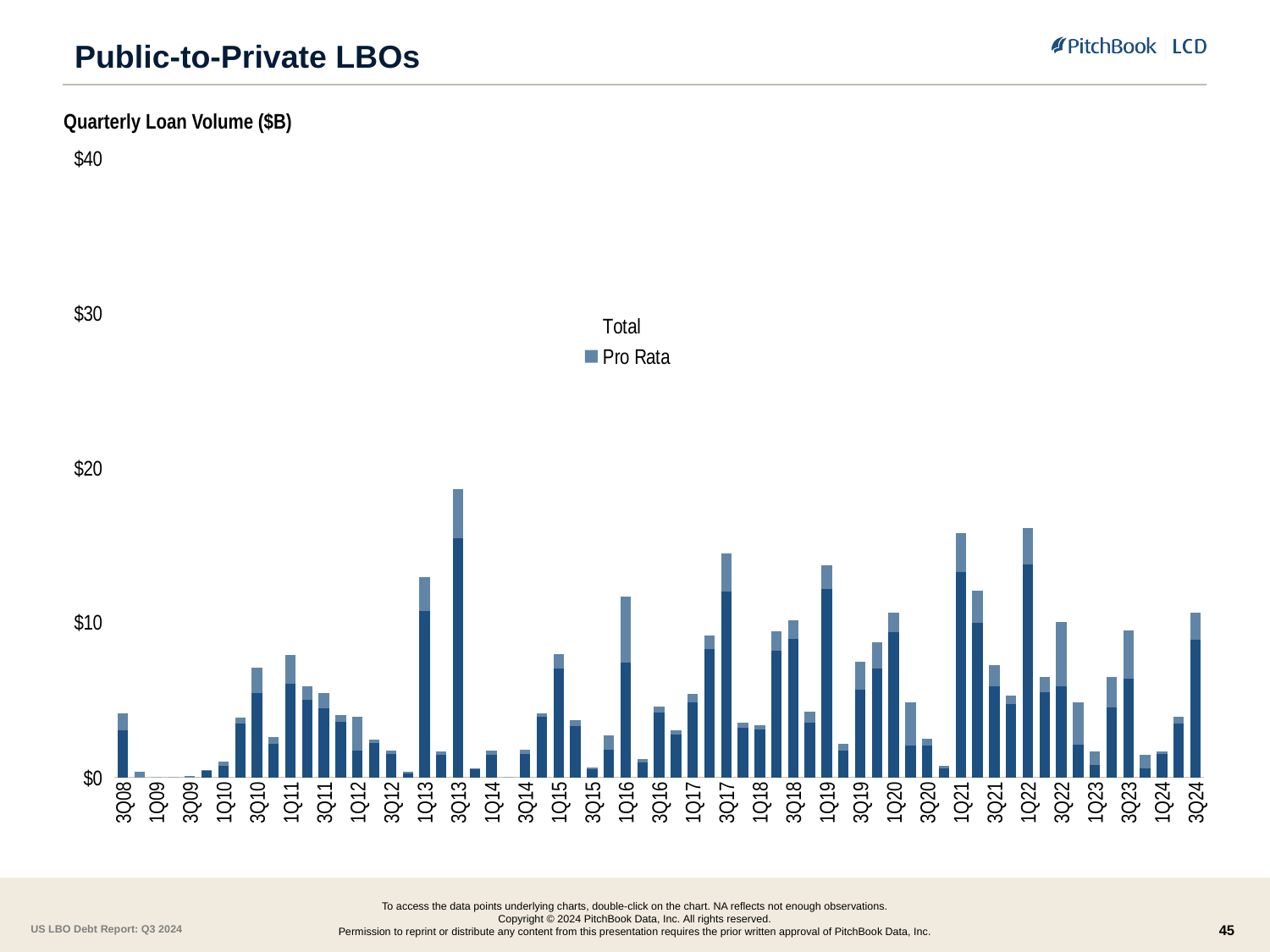
Which quarter has the larger total loan volume, 1Q21 or 3Q12? 1Q21 Is the total value for 3Q13 greater or less than $10? greater Is the total value for 3Q12 greater or less than $10? less What kind of chart is shown on the slide? bar chart Is the total value for 1Q21 greater or less than $10? greater What are the two series named in the chart legend? Total and Pro Rata How many series does the chart legend list? 2 Which quarter has the highest total loan volume? 3Q13 What is the title of the chart? Quarterly Loan Volume ($B) Which quarter has the larger total loan volume, 3Q13 or 1Q09? 3Q13